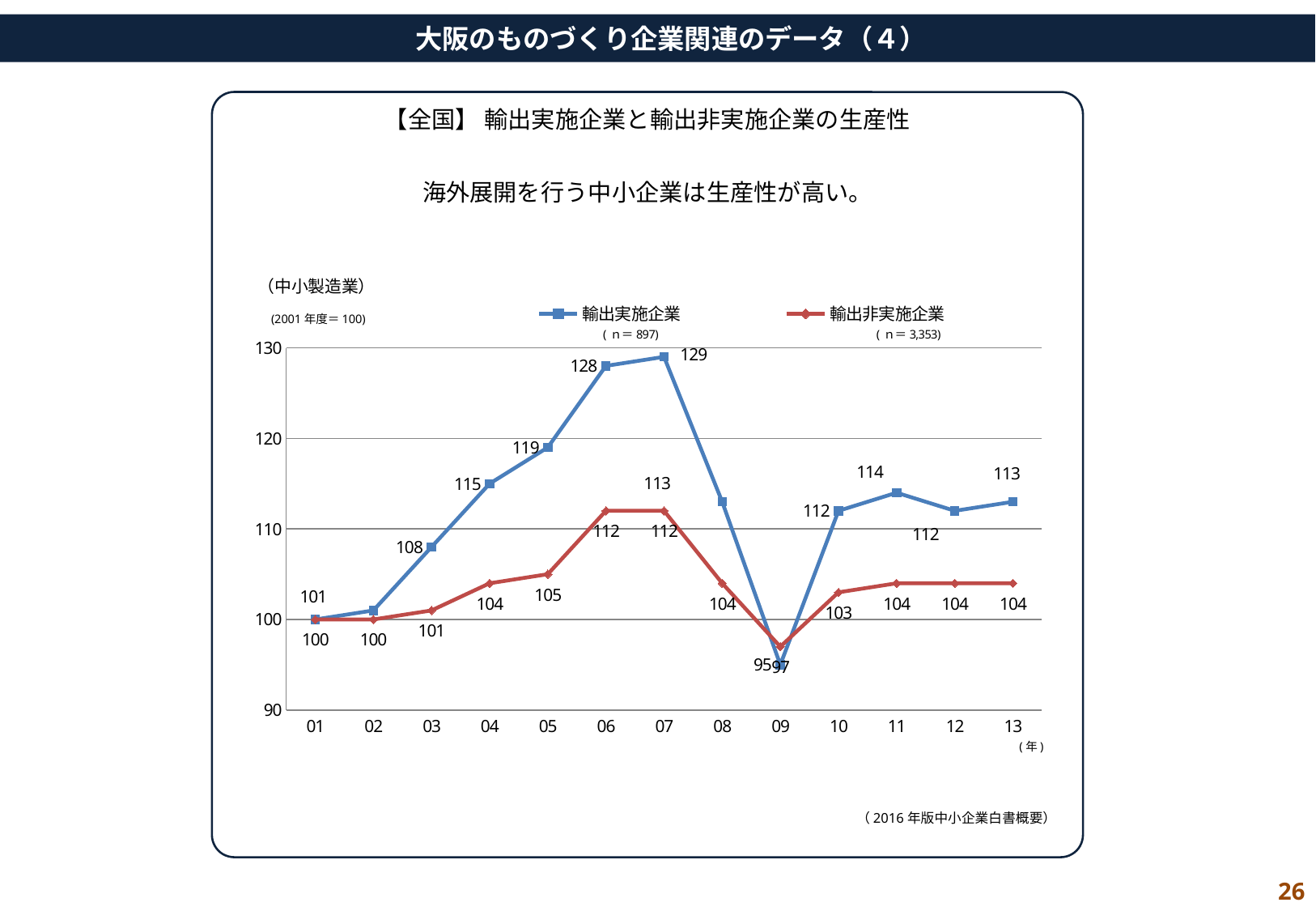
What is the value for 輸出実施企業 in 07? 129 What is the sample size (n) shown in the legend for 輸出実施企業? 897 In which year does 輸出実施企業 reach its lowest value? 09 What is the value for 輸出実施企業 in 06? 128 Does the value for 輸出実施企業 rise or fall from 03 to 07? rise What is the difference between 輸出実施企業 and 輸出非実施企業 in 07? 17 In 11, which series has the higher value, 輸出実施企業 or 輸出非実施企業? 輸出実施企業 How many years are plotted along the x axis? 13 How many series does the legend list? 2 In which year does 輸出実施企業 reach its highest value? 07 What kind of chart is shown on the slide? line chart What is the value for 輸出非実施企業 in 13? 104